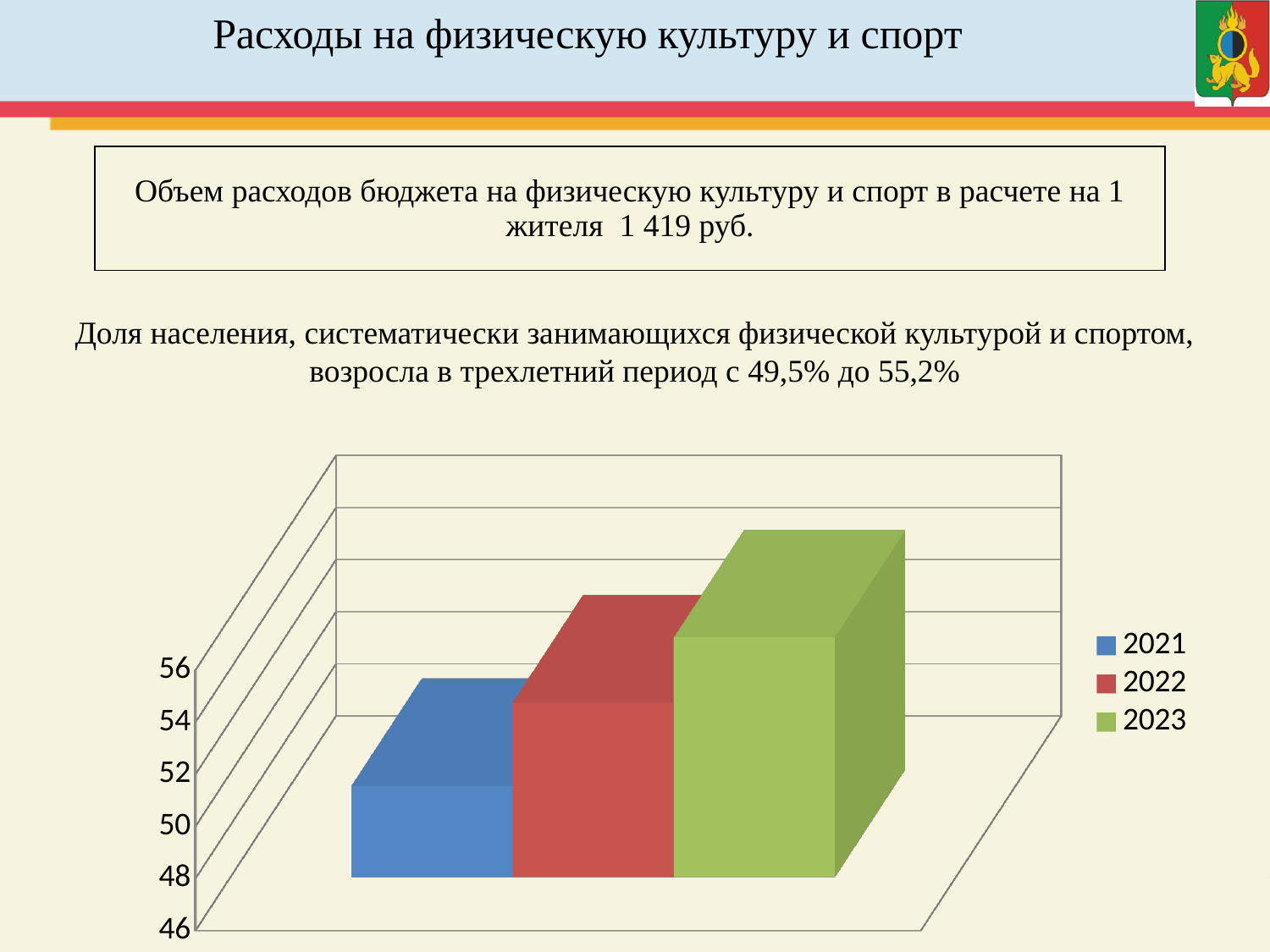
Which year has the highest bar in the chart? 2023 What colour is the bar for 2022 in the chart? red How many bars are plotted in the chart? 3 How many series does the chart legend list? 3 What kind of chart is shown on the slide? bar chart Which bar is taller, 2021 or 2023? 2023 Which year has the lowest bar in the chart? 2021 Do the bar values rise or fall from 2021 to 2023? rise Which years are listed in the chart legend? 2021, 2022, 2023 Is the value for 2023 greater or less than 52? greater Is the value for 2021 greater or less than 54? less Which bar is taller, 2022 or 2021? 2022